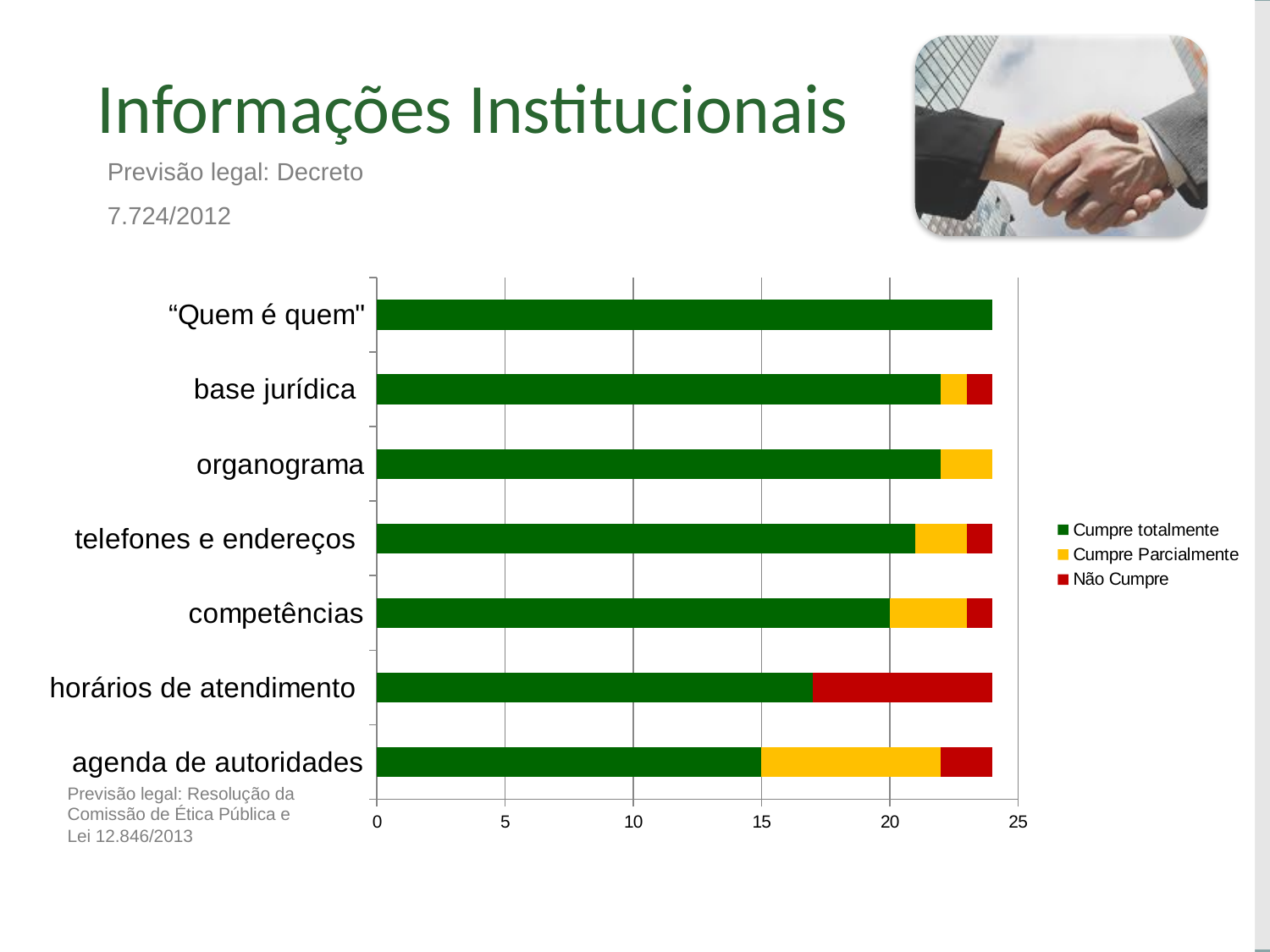
Which category has the largest 'Cumpre Parcialmente' segment? agenda de autoridades Is the 'Cumpre totalmente' value for 'horários de atendimento' greater or less than 20? less What are the three legend entries of the chart? Cumpre totalmente, Cumpre Parcialmente, Não Cumpre Is the 'Cumpre totalmente' value for 'base jurídica' greater or less than 20? greater What colour represents the 'Não Cumpre' series in the chart? Red Which category has the largest 'Não Cumpre' segment? horários de atendimento How many series does the chart legend list? 3 How many categories are plotted on the chart? 7 What kind of chart is shown on the slide? Stacked bar chart Which category has the smallest 'Cumpre totalmente' segment? agenda de autoridades Which category has the largest 'Cumpre totalmente' segment? "Quem é quem" Which has a larger 'Cumpre totalmente' segment: 'horários de atendimento' or 'agenda de autoridades'? horários de atendimento